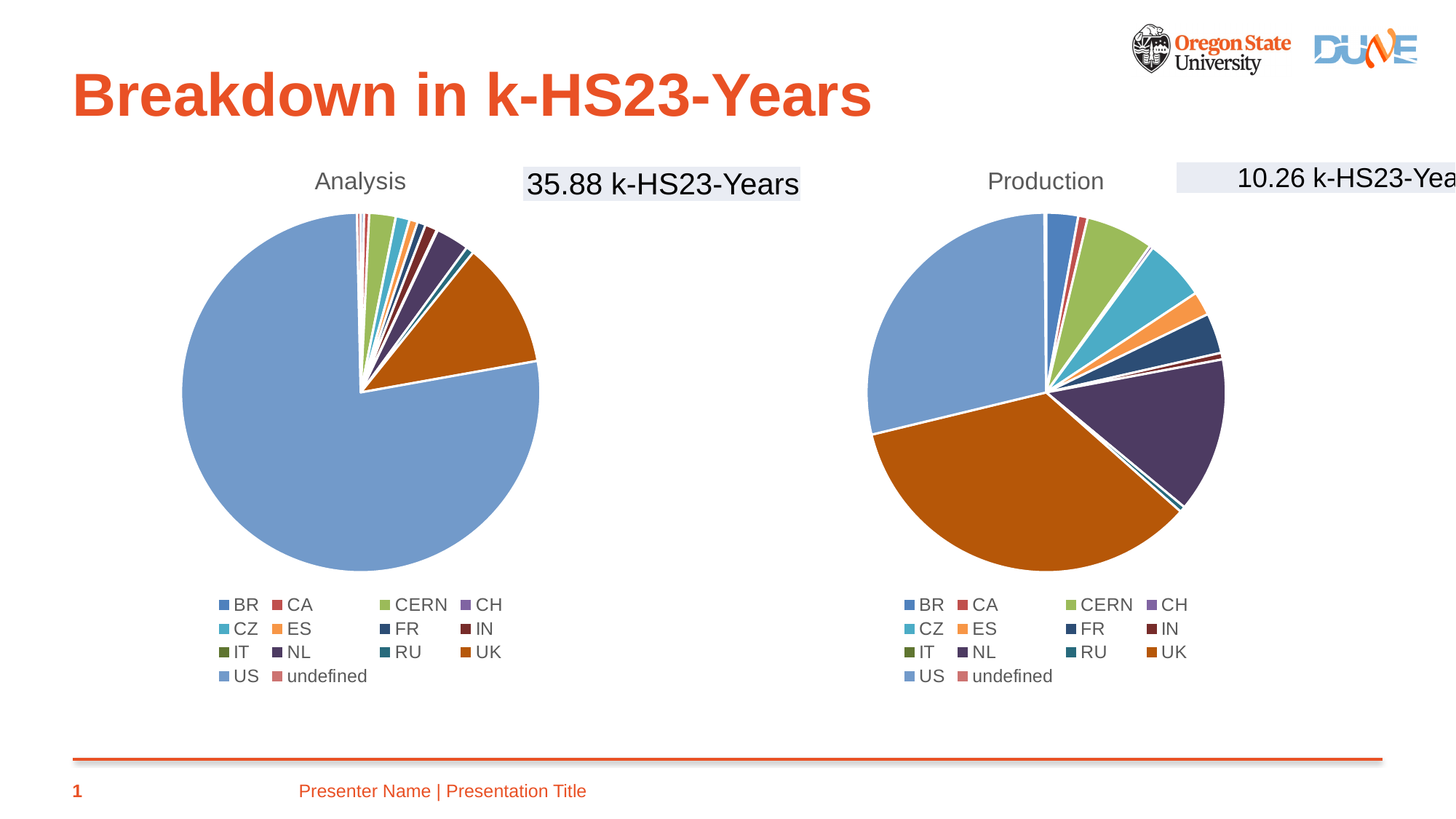
In the Production chart, which is larger, the CERN slice or the CA slice? CERN What kind of chart is the Production chart? pie chart What is the title of the left-hand pie chart? Analysis In the Production chart, which is larger, the US slice or the UK slice? UK How many categories does the legend of the Analysis chart list? 14 What is the title of the right-hand pie chart? Production How many categories does the legend of the Production chart list? 14 What kind of chart is the Analysis chart? pie chart In the Analysis chart, which is larger, the UK slice or the CERN slice? UK In the Analysis chart, which category has the largest slice? US